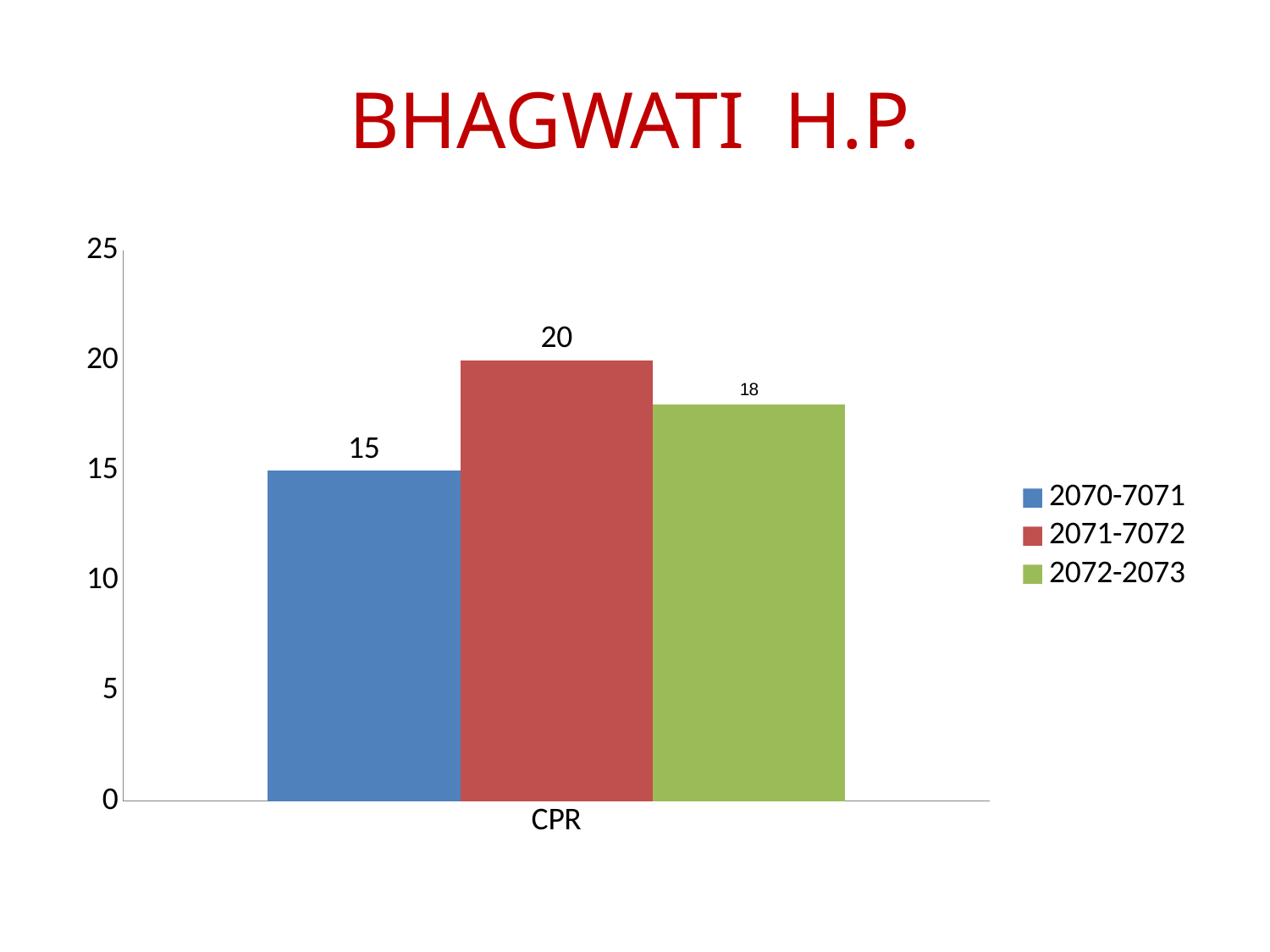
Which series has the highest CPR value? 2071-7072 What kind of chart is shown on the slide? bar chart Which is larger, the CPR value for 2072-2073 or for 2070-7071? 2072-2073 How many series does the legend list? 3 What is the CPR value for the 2070-7071 series? 15 What is the CPR value for the 2072-2073 series? 18 What is the difference between the CPR values for 2071-7072 and 2072-2073? 2 What is the category label on the x axis? CPR What is the difference between the CPR values for 2071-7072 and 2070-7071? 5 What is the title of the slide? BHAGWATI H.P. Which series has the lowest CPR value? 2070-7071 What is the CPR value for the 2071-7072 series? 20